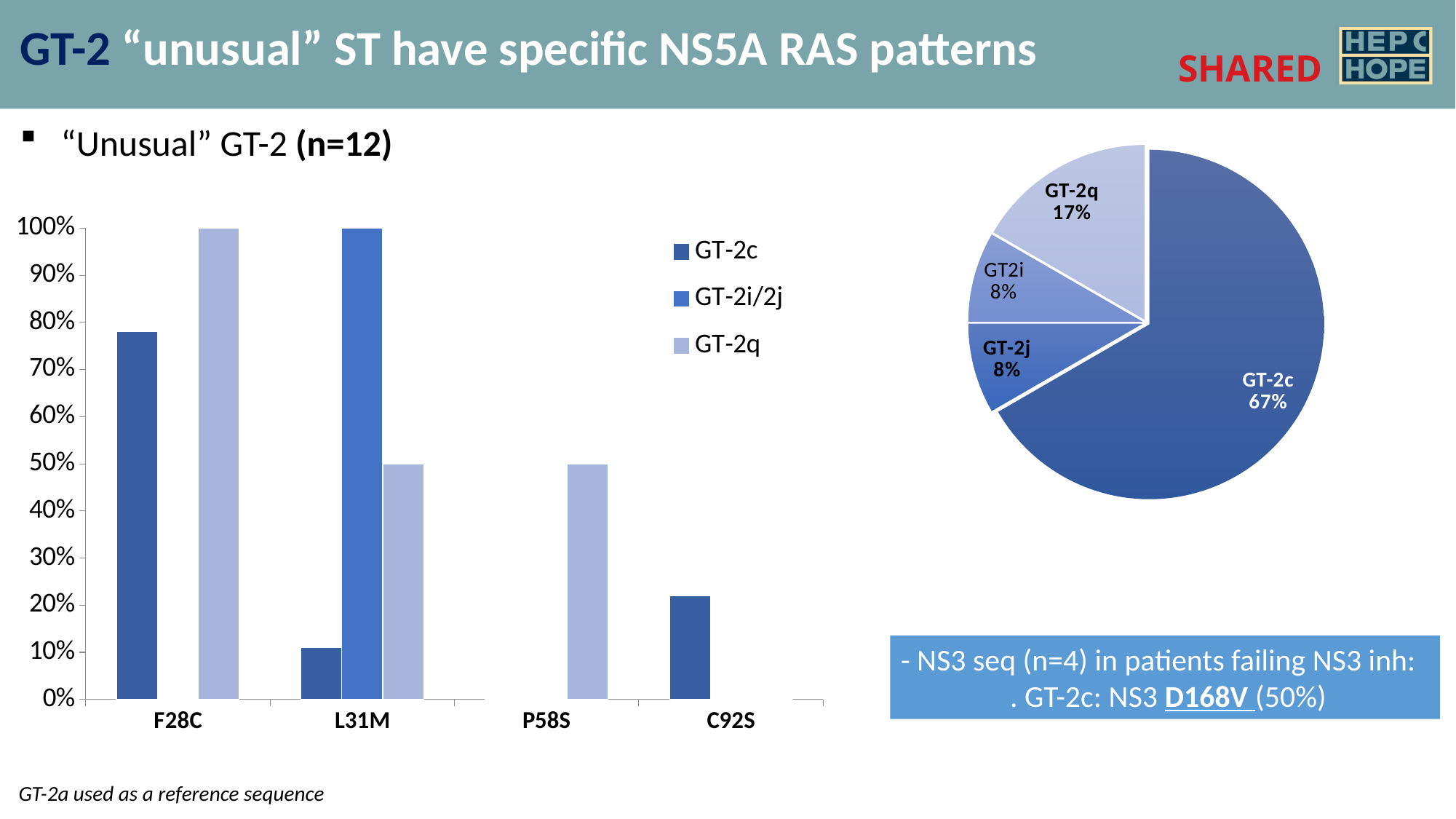
In the pie chart on the right, what share does GT-2c have? 67% In the bar chart on the left, how many series does the legend list? 3 In the bar chart on the left, is the value for GT-2c at C92S greater or less than 30%? less What kind of chart is the chart on the left of the slide? bar chart In the bar chart on the left, which series has the higher value at L31M: GT-2c or GT-2q? GT-2q In the bar chart on the left, what is the value for GT-2i/2j at L31M? 100% In the pie chart on the right, which slice is the largest? GT-2c In the bar chart on the left, what is the value for GT-2q at F28C? 100% In the pie chart on the right, what is the difference between the GT-2q share and the GT-2j share? 9% In the bar chart on the left, what is the value for GT-2q at P58S? 50% In the bar chart on the left, is the value for GT-2c at F28C greater or less than 70%? greater In the bar chart on the left, how many categories are shown on the x axis? 4